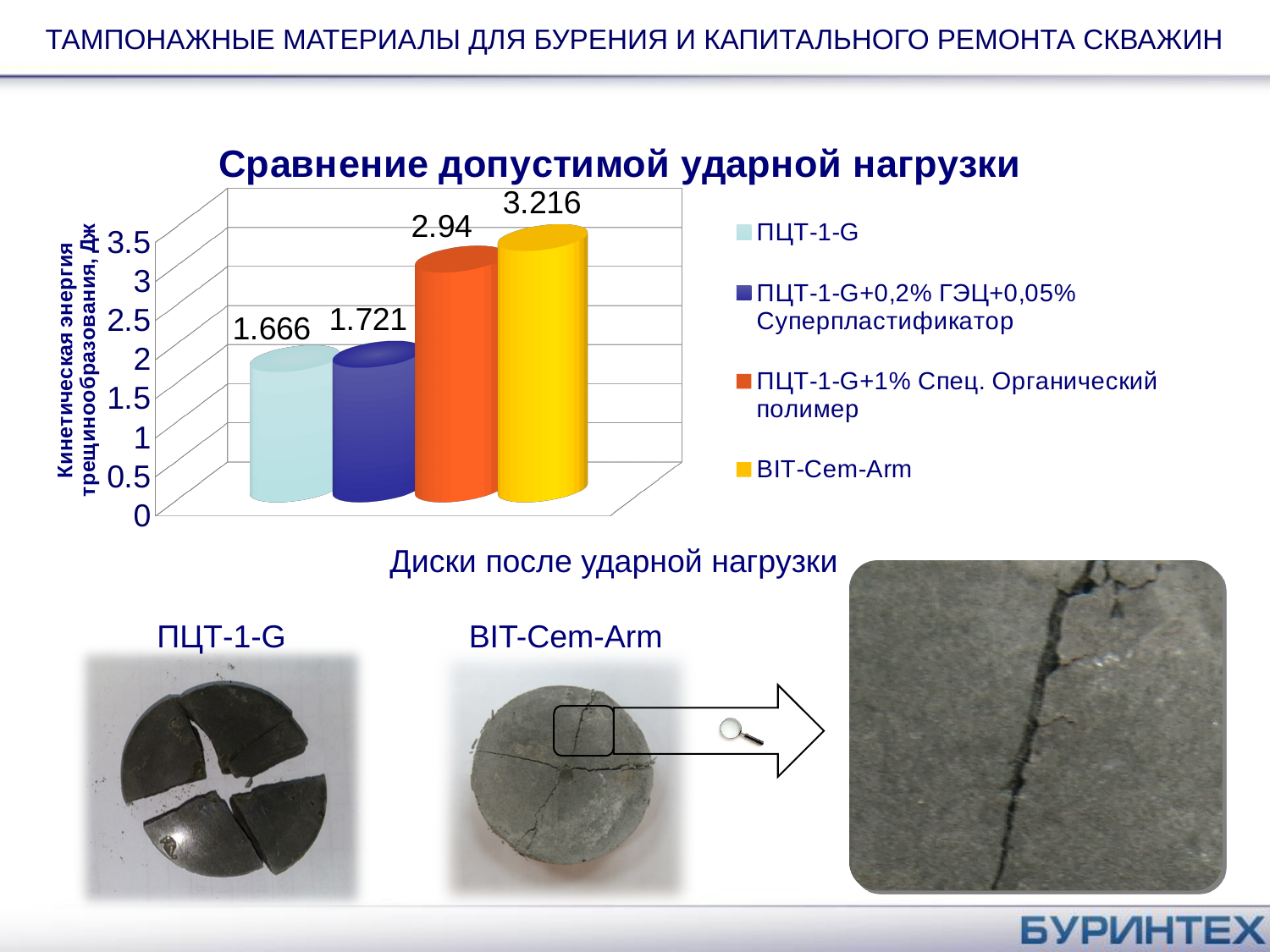
Which is larger: the value for ПЦТ-1-G+1% Спец. Органический полимер or the value for ПЦТ-1-G+0,2% ГЭЦ+0,05% Суперпластификатор? ПЦТ-1-G+1% Спец. Органический полимер What kind of chart is shown on the slide? Bar chart What is the value for BIT-Cem-Arm in the chart? 3.216 How many series does the legend list? 4 What is the value for ПЦТ-1-G+1% Спец. Органический полимер? 2.94 Which series has the lowest value in the chart? ПЦТ-1-G Which series has the highest value in the chart? BIT-Cem-Arm What is the title of the chart? Сравнение допустимой ударной нагрузки Is the value for BIT-Cem-Arm greater or less than 3? greater What is the difference between the values for BIT-Cem-Arm and ПЦТ-1-G? 1.55 What is the value for ПЦТ-1-G+0,2% ГЭЦ+0,05% Суперпластификатор? 1.721 What is the value for ПЦТ-1-G in the chart? 1.666